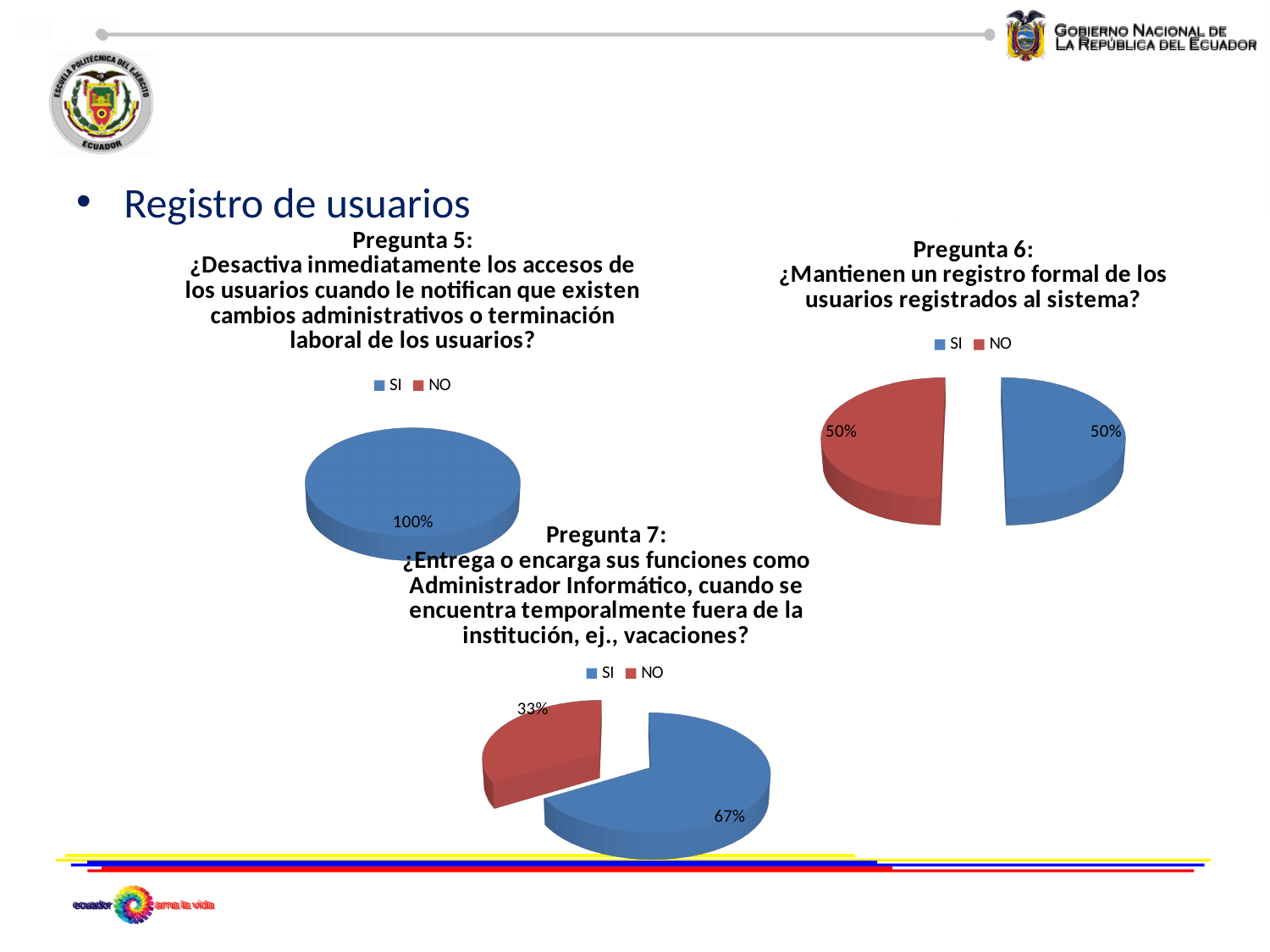
In the Pregunta 6 chart, what share of the pie is SI? 50% In the Pregunta 5 chart, what share of the pie is SI? 100% What kind of chart is the Pregunta 5 chart? pie chart In the Pregunta 7 chart, what is the difference between the SI and NO shares? 34% In the Pregunta 6 chart, what colour is the SI slice? blue In the Pregunta 7 chart, what share of the pie is NO? 33% How many pie charts are on the slide? 3 How many series does the legend of the Pregunta 5 chart list? 2 What are the two legend entries in the Pregunta 7 chart? SI and NO In the Pregunta 7 chart, which slice is larger, SI or NO? SI